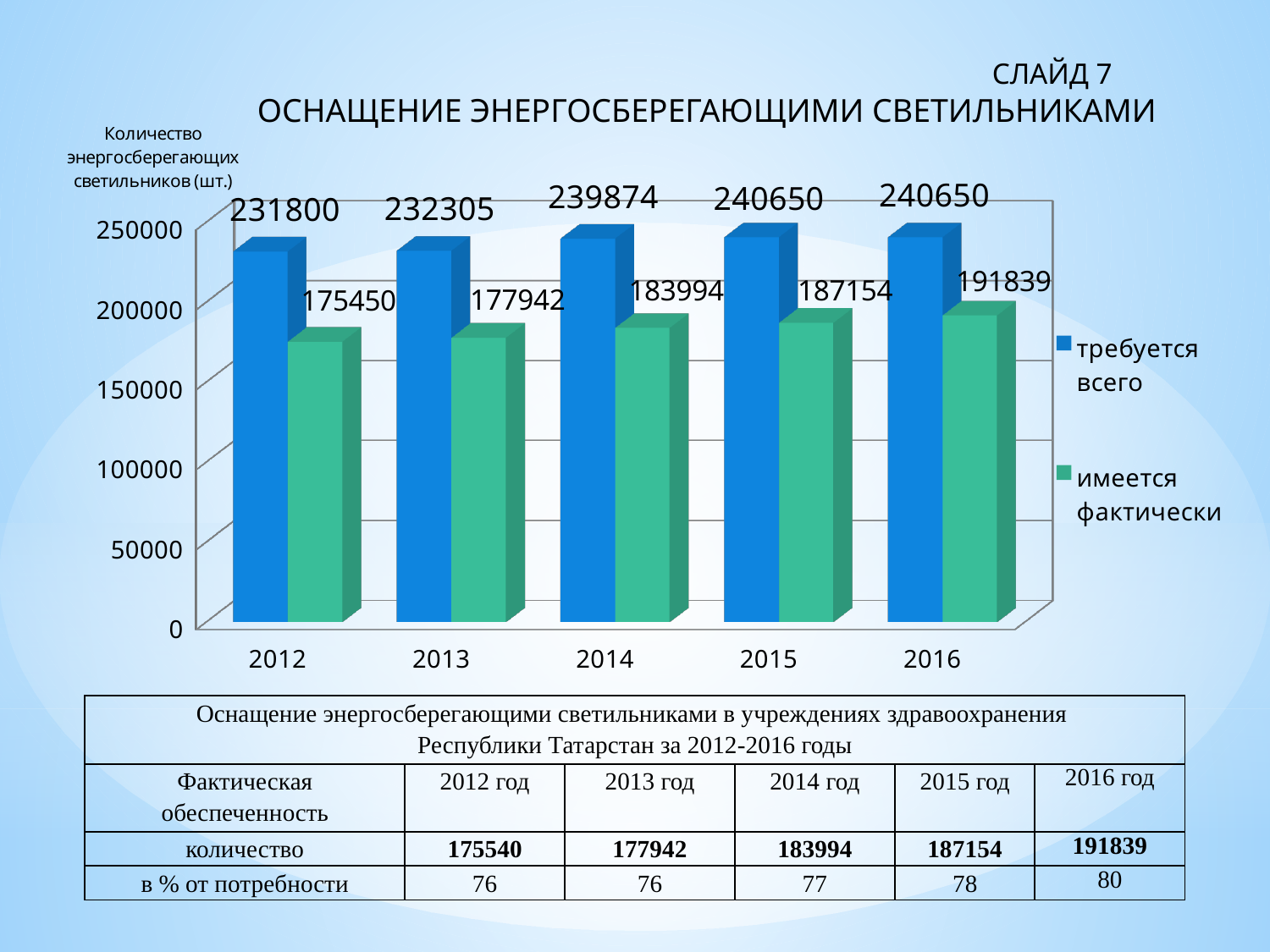
How many years are shown on the x axis of the chart? 5 In which year is the "имеется фактически" series lowest? 2012 What is the value of the "требуется всего" series for 2014? 239874 In which year is the "имеется фактически" series highest? 2016 Which is larger in 2013: "требуется всего" or "имеется фактически"? требуется всего What is the difference between "требуется всего" and "имеется фактически" in 2015? 53496 Does the "имеется фактически" series rise or fall from 2012 to 2016? rise Is the value of "имеется фактически" for 2014 greater or less than 200000? less What type of chart is shown on the slide? bar chart What is the value of the "имеется фактически" series for 2016? 191839 How many series does the chart legend list? 2 What is the value of the "имеется фактически" series for 2012 as labelled on the chart? 175450